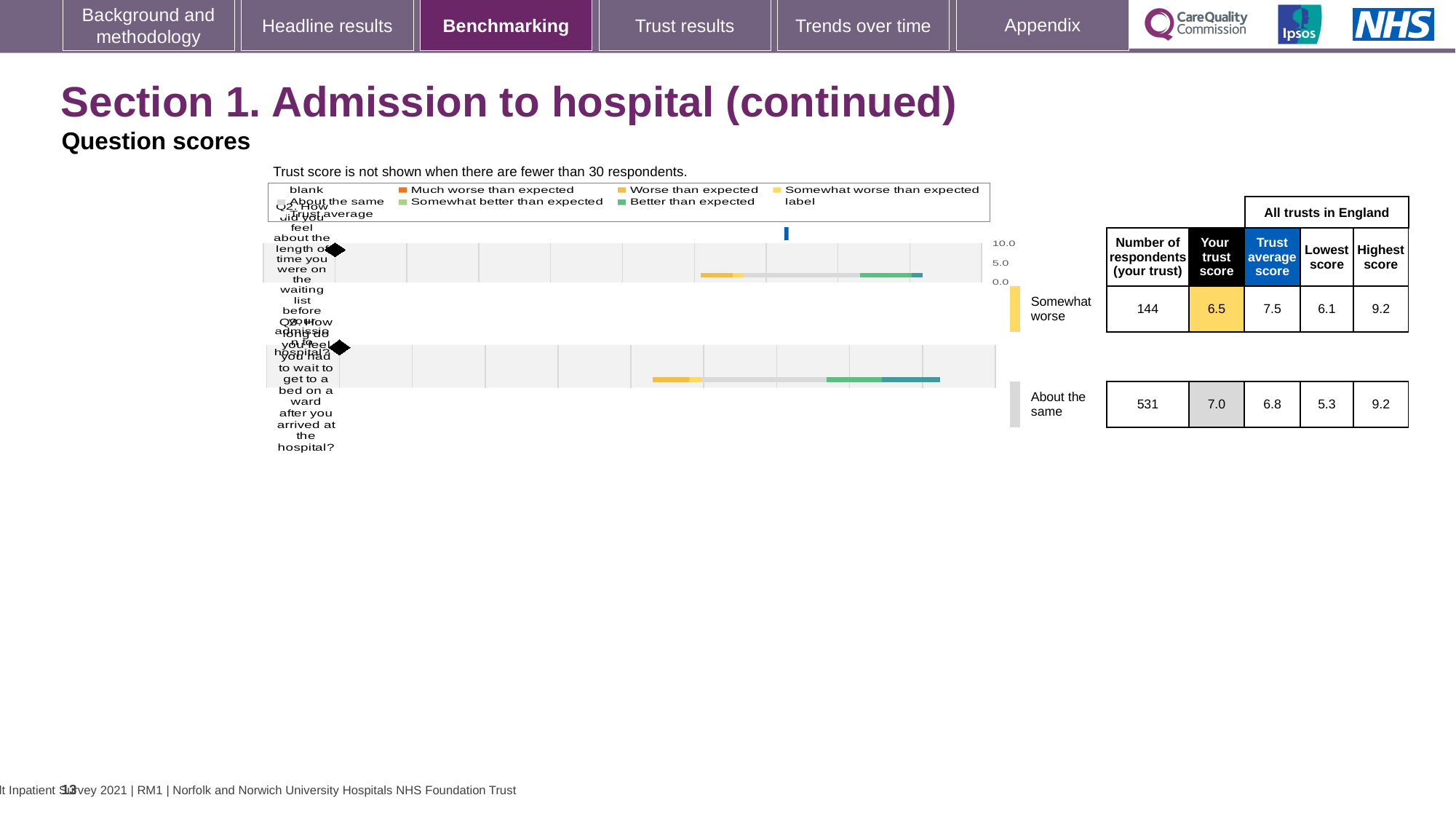
How many respondents answered Q3 at this trust? 531 What is the trust score for Q2 (how did you feel about the length of time on the waiting list before admission)? 6.5 How many respondents answered Q2 at this trust? 144 What is the trust average score across all trusts in England for Q2? 7.5 What is the lowest score among all trusts in England for Q3? 5.3 How is this trust's result for Q3 categorised relative to expectations? About the same How is this trust's result for Q2 categorised relative to expectations? Somewhat worse Which is larger for Q3: this trust's score or the trust average score? This trust's score (7.0) What is the difference between the trust average score and this trust's score for Q2? 1.0 What is the trust score for Q3 (how long did you feel you had to wait to get to a bed on a ward)? 7.0 What is the highest score among all trusts in England for Q2? 9.2 What is the maximum value shown on the chart's score axis? 10.0